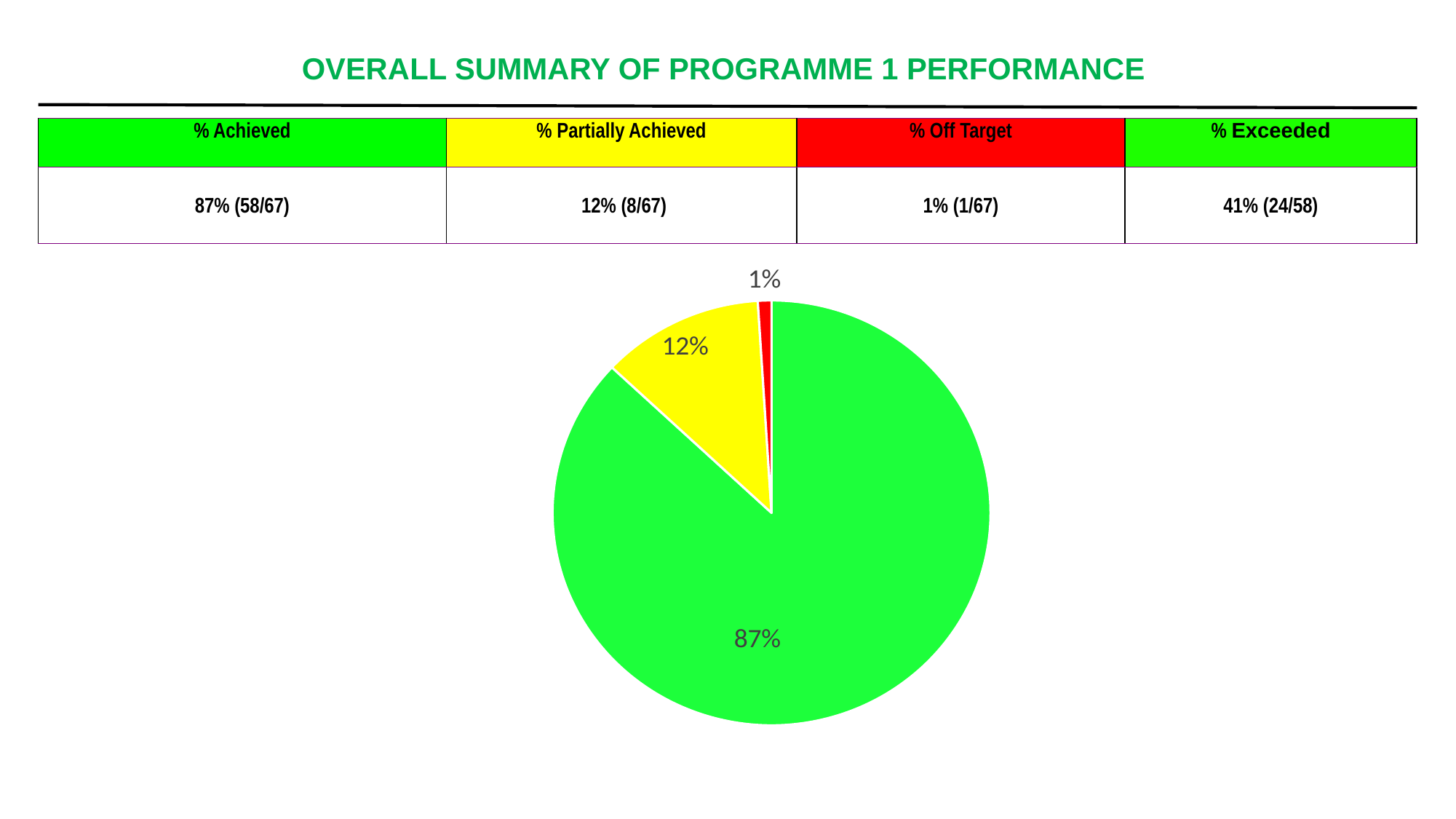
Which slice of the pie chart is the largest? the green slice (87%) What is the title of the slide containing the pie chart? OVERALL SUMMARY OF PROGRAMME 1 PERFORMANCE Which slice of the pie chart is the smallest? the red slice (1%) What share of the pie does the green slice represent? 87% What share of the pie does the red slice represent? 1% Which is larger in the pie chart, the yellow slice or the red slice? the yellow slice What share of the pie does the yellow slice represent? 12% What kind of chart is shown on the slide? pie chart What is the difference between the largest and smallest slices of the pie chart? 86% How many slices does the pie chart have? 3 What colour is the slice labelled 12% in the pie chart? yellow What is the difference between the green slice and the yellow slice of the pie chart? 75%